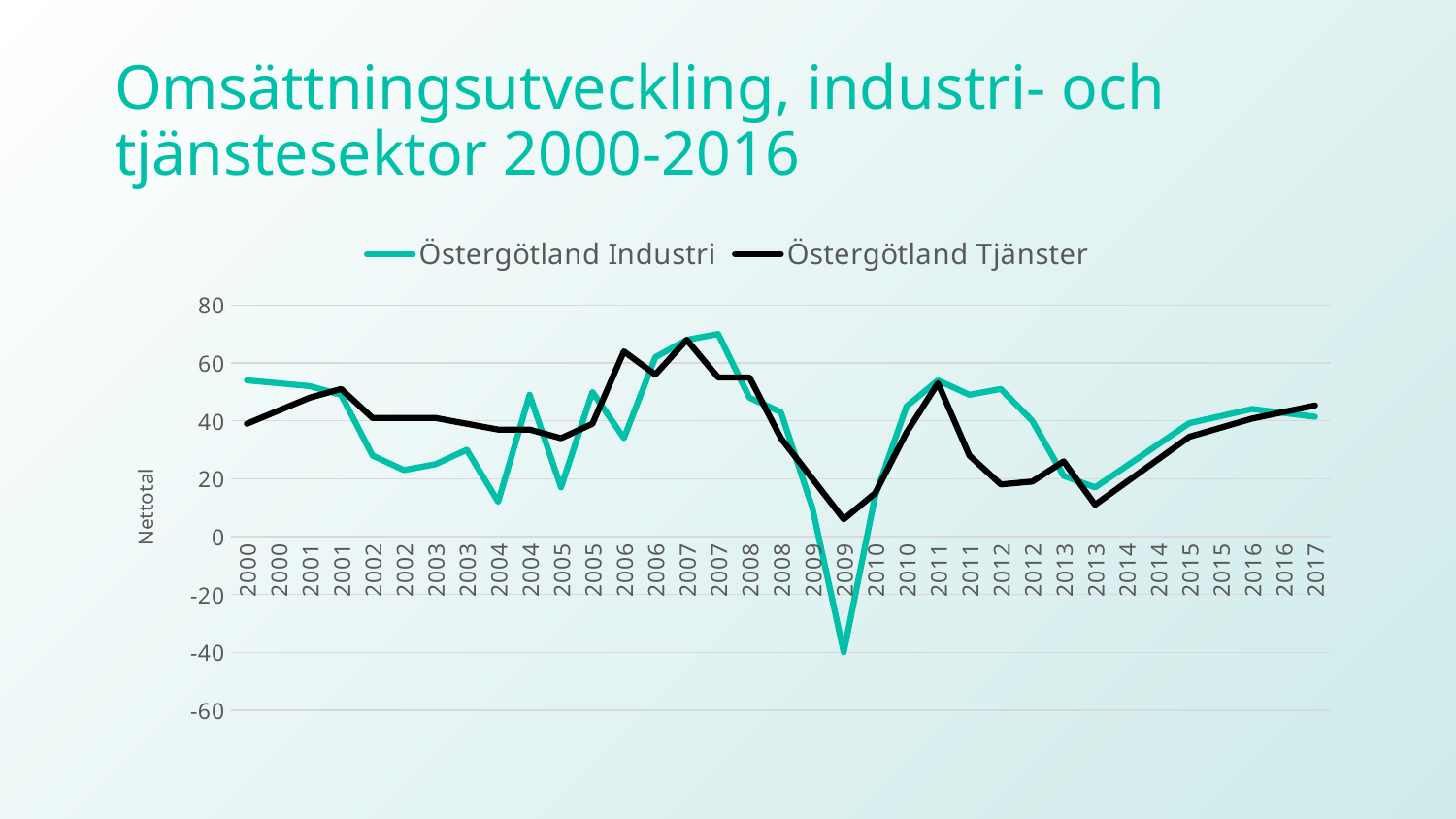
What are the two series named in the legend? Östergötland Industri and Östergötland Tjänster Is the peak value of the Östergötland Industri line in 2007 greater or less than 60? greater Is the lowest value of the Östergötland Industri line (in 2009) greater or less than -20? less How many series does the legend list? 2 Do both lines rise or fall between 2007 and 2009? fall What kind of chart is shown on the slide? line chart What is the label on the vertical axis? Nettotal In which year does the Östergötland Industri line reach its lowest value? 2009 At the first 2012 point, which series is higher, Östergötland Industri or Östergötland Tjänster? Östergötland Industri Is the lowest value of the Östergötland Tjänster line in 2009 greater or less than 20? less In which year does the Östergötland Industri line reach its highest value? 2007 At the low point in 2009, which series has the higher value, Östergötland Industri or Östergötland Tjänster? Östergötland Tjänster